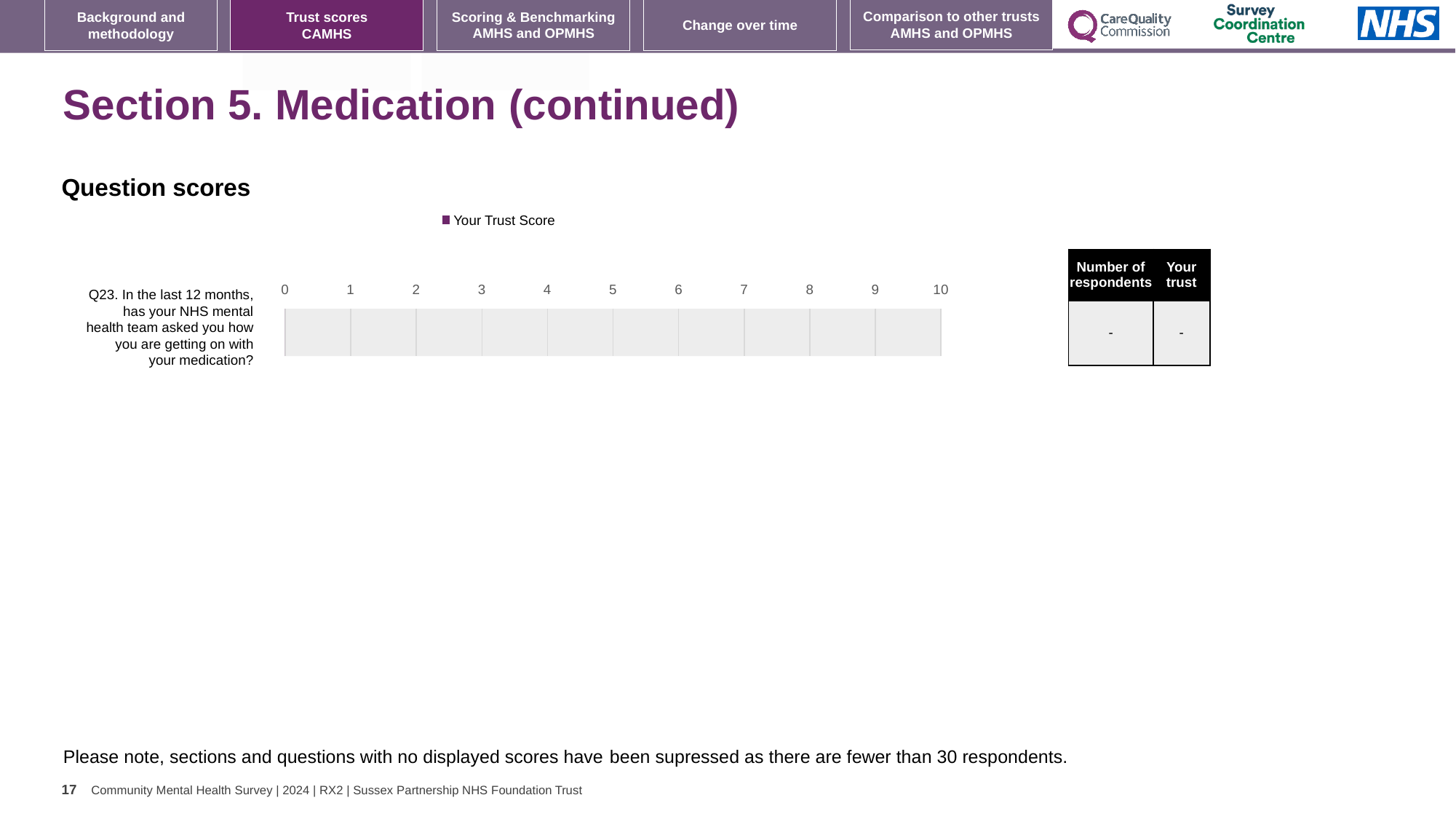
What is the highest value shown on the chart's horizontal axis? 10 Which question number is the category on the chart? Q23 What kind of chart is shown under 'Question scores'? bar chart How many series does the chart legend list? 1 What is the name of the series listed in the chart legend? Your Trust Score How many question categories are plotted on the chart? 1